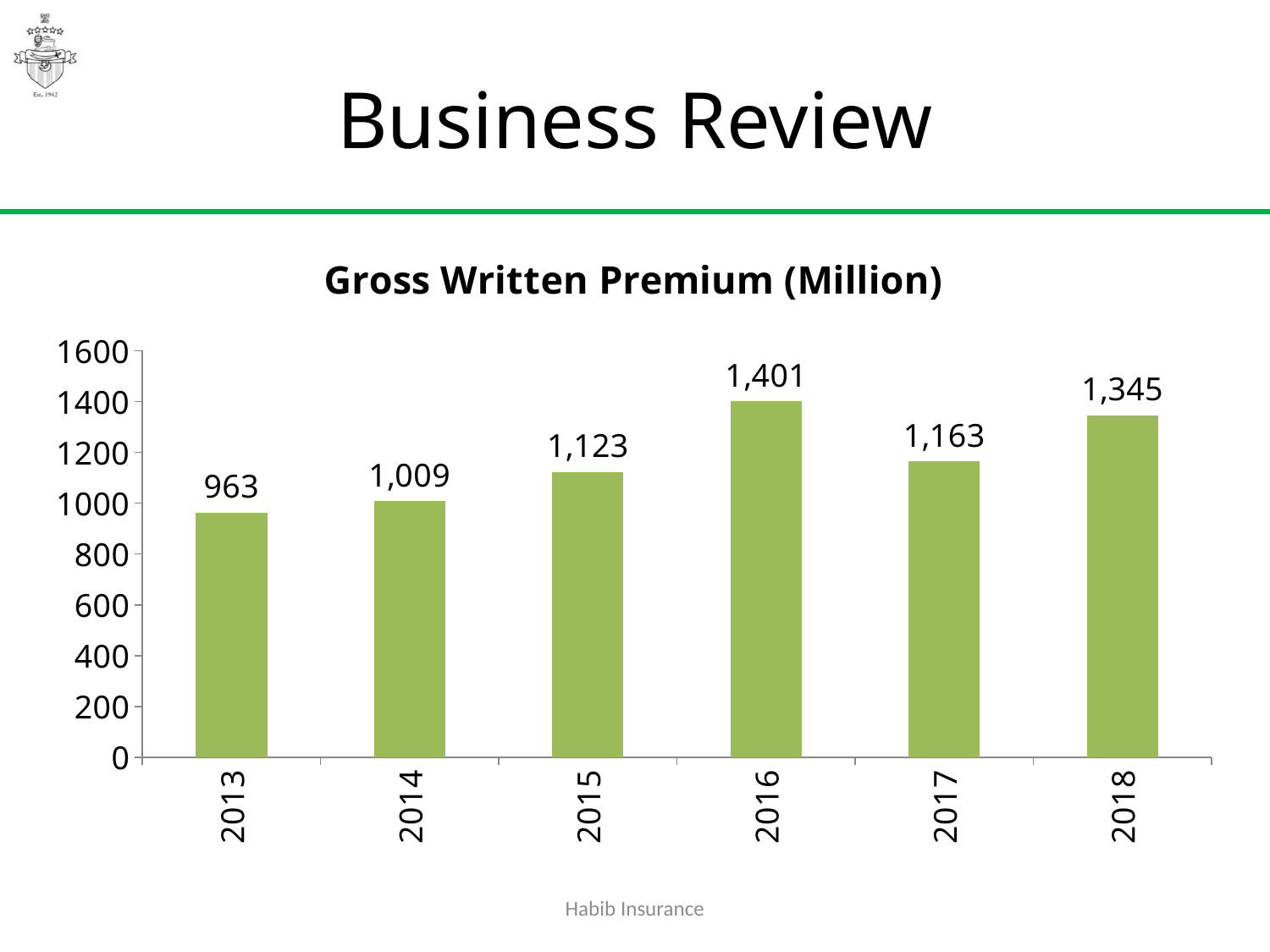
How many years are shown on the chart? 6 What type of chart is used to show Gross Written Premium? bar chart What is the difference between the Gross Written Premium in 2016 and 2017? 238 What is the Gross Written Premium for 2013? 963 Which year has the highest Gross Written Premium? 2016 What is the title of the chart? Gross Written Premium (Million) Is the Gross Written Premium for 2014 greater or less than 1200? less Which year has the lowest Gross Written Premium? 2013 What is the Gross Written Premium for 2016? 1,401 What is the difference between the Gross Written Premium in 2018 and 2013? 382 Which year has a higher Gross Written Premium, 2015 or 2017? 2017 What is the Gross Written Premium for 2018? 1,345